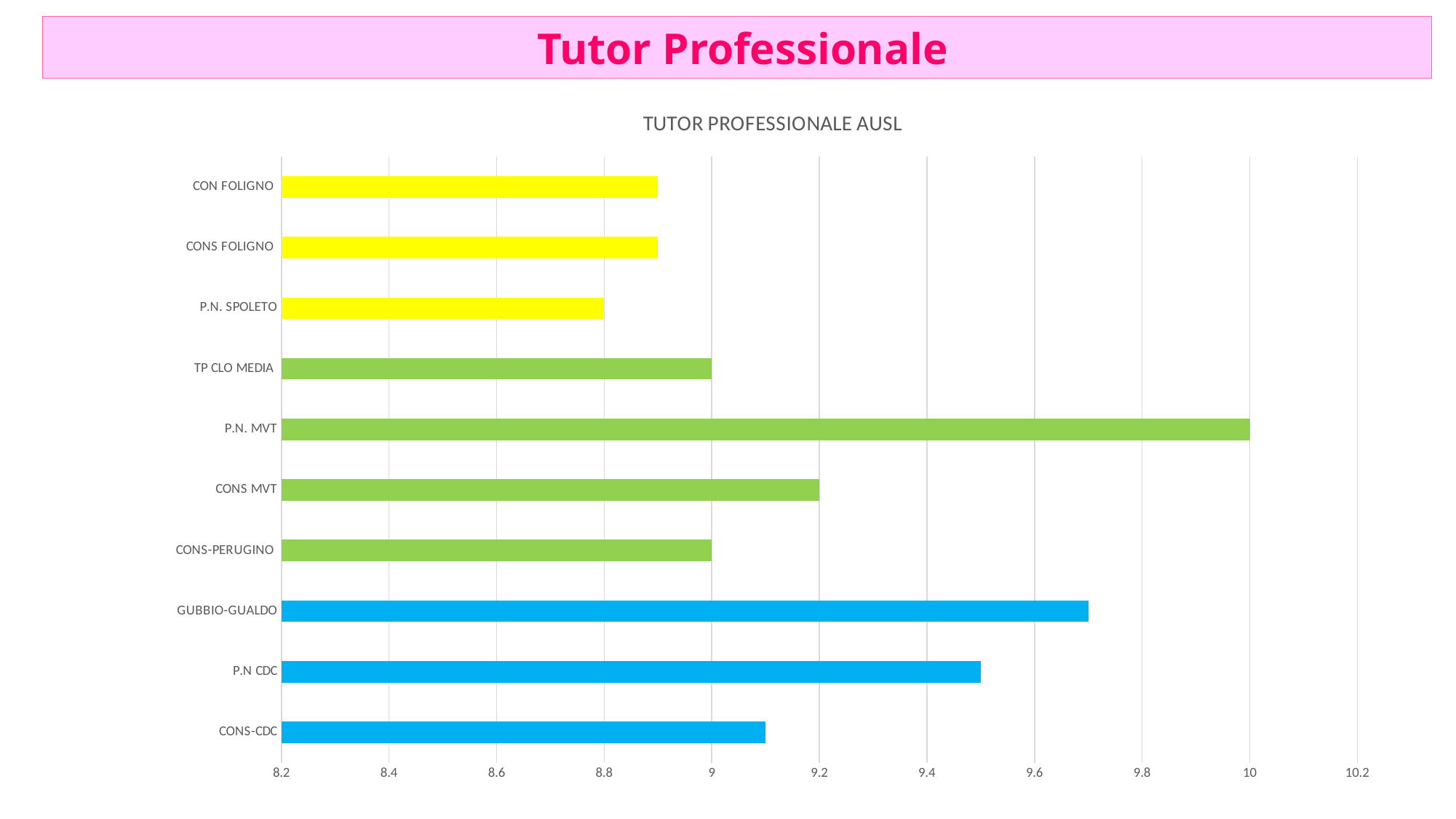
Is the value for GUBBIO-GUALDO greater or less than 9.8? less What is the value for CONS MVT? 9.2 Which category has the lowest value? P.N. SPOLETO What kind of chart is shown on the slide? bar chart What is the value for P.N. SPOLETO? 8.8 Is the value for CONS-CDC greater or less than 9? greater How many categories are plotted in the chart? 10 Which category has the highest value? P.N. MVT What is the title of the chart? TUTOR PROFESSIONALE AUSL Which is larger, the value for GUBBIO-GUALDO or the value for P.N CDC? GUBBIO-GUALDO What is the value for P.N. MVT? 10 What is the difference between the values for P.N. MVT and CONS MVT? 0.8